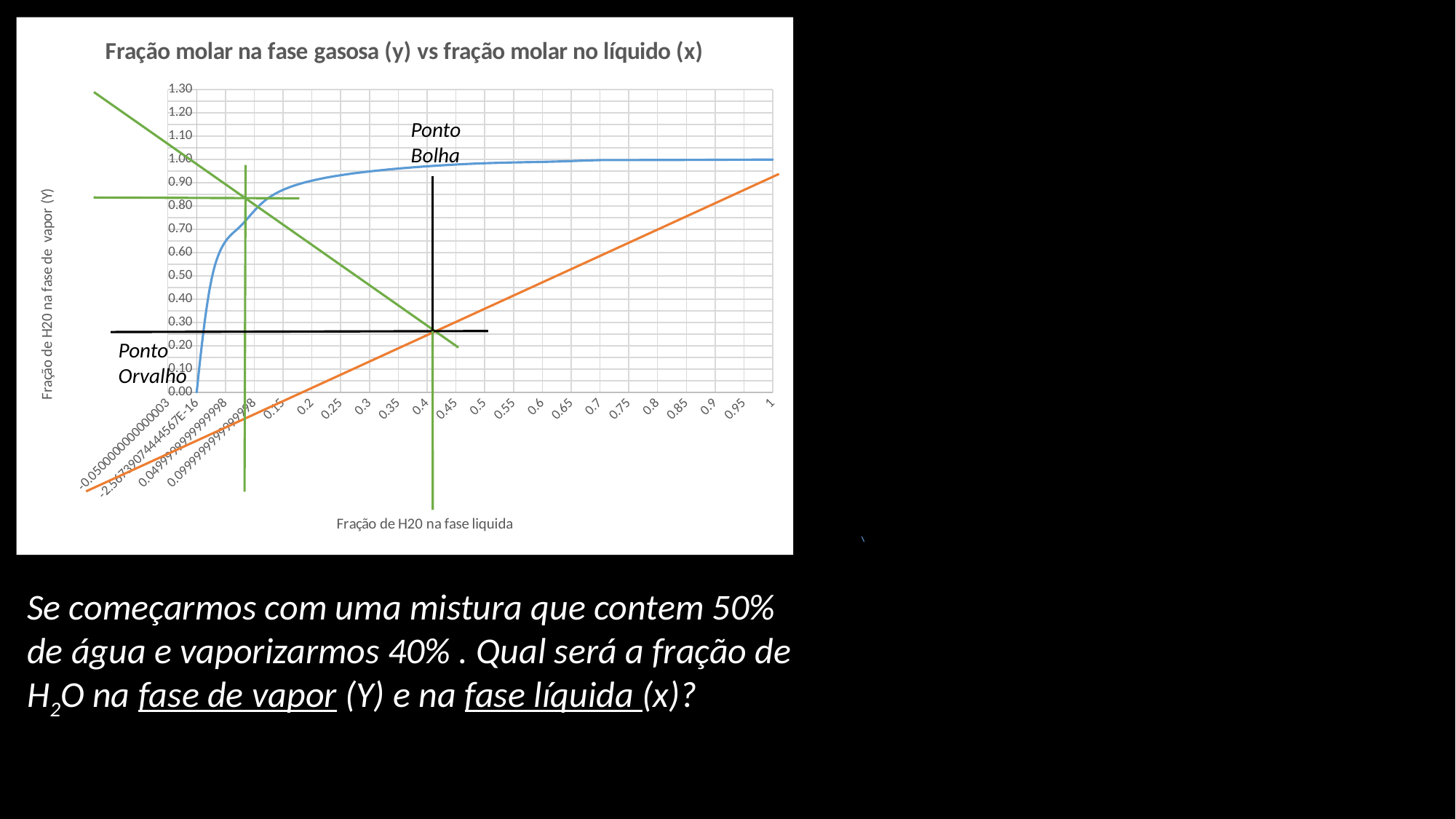
Is the value of the blue curve at x = 0.5 greater or less than 0.90? greater Does the blue curve rise or fall as the x value increases? rises What is the title of the chart? Fração molar na fase gasosa (y) vs fração molar no líquido (x) Is the value of the orange line at x = 0.8 greater or less than 0.90? less Does the orange line rise or fall as the x value increases? rises What is the lowest tick value shown on the vertical axis? 0.00 What is the label of the vertical axis of the chart? Fração de H20 na fase de vapor (Y) Is the value of the blue curve at x = 0.3 greater or less than 0.80? greater What is the highest tick value shown on the vertical axis? 1.30 At x = 0.5, which is larger: the blue curve or the orange line? the blue curve What type of chart is shown on the slide? line chart